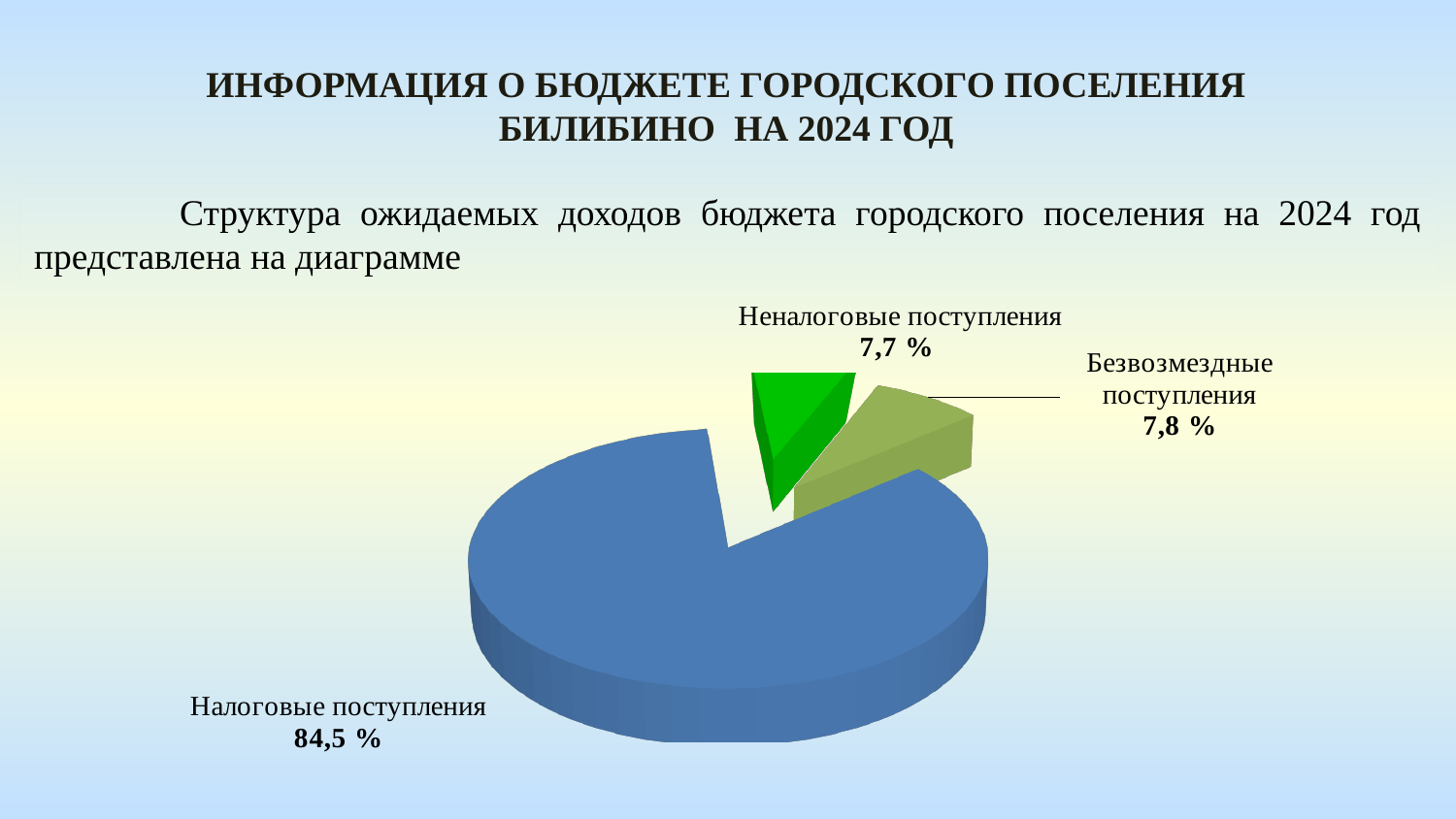
What colour is the slice for Налоговые поступления? Blue Which category has the largest slice of the pie? Налоговые поступления How many slices does the pie chart have? 3 What is the difference between the shares of Налоговые поступления and Неналоговые поступления? 76,8 % What is the difference between the shares of Безвозмездные поступления and Неналоговые поступления? 0,1 % What is the value shown for Неналоговые поступления? 7,7 % Which category has the smallest slice of the pie? Неналоговые поступления What is the difference between the shares of Налоговые поступления and Безвозмездные поступления? 76,7 % What is the value shown for Безвозмездные поступления? 7,8 % What kind of chart is shown on the slide? Pie chart What share of the pie does Налоговые поступления represent? 84,5 % Which is larger: the share of Налоговые поступления or the share of Безвозмездные поступления? Налоговые поступления